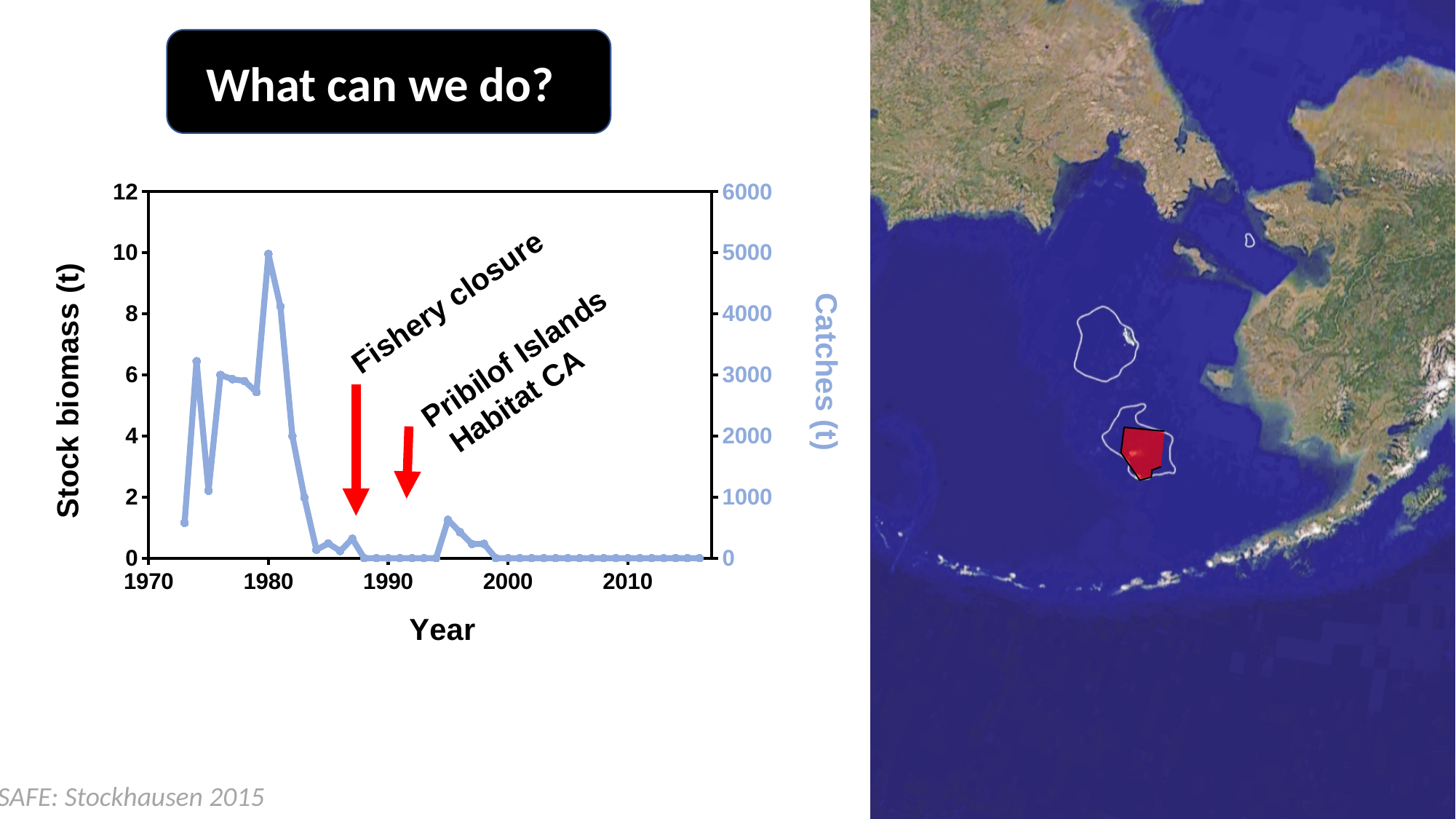
Between 1980 and 1984, does the line rise or fall? fall What is the label of the right-hand y axis of the chart? Catches (t) On the right-hand Catches (t) axis, is the value around 1995 greater or less than 1000? less Which is larger, the value around 1980 or the value around 1995? 1980 On the right-hand Catches (t) axis, is the peak value around 1980 greater or less than 4000? greater What kind of chart is shown on the left of the slide? line chart Which is larger, the value around 1975 or the value around 1976? 1976 What is the label of the x axis of the chart? Year Around which year does the line reach its highest value? 1980 What value does the line show for the years from 2000 onward? 0 What is the highest tick value shown on the left-hand Stock biomass (t) axis? 12 On the right-hand Catches (t) axis, is the value around 1974 greater or less than 2000? greater